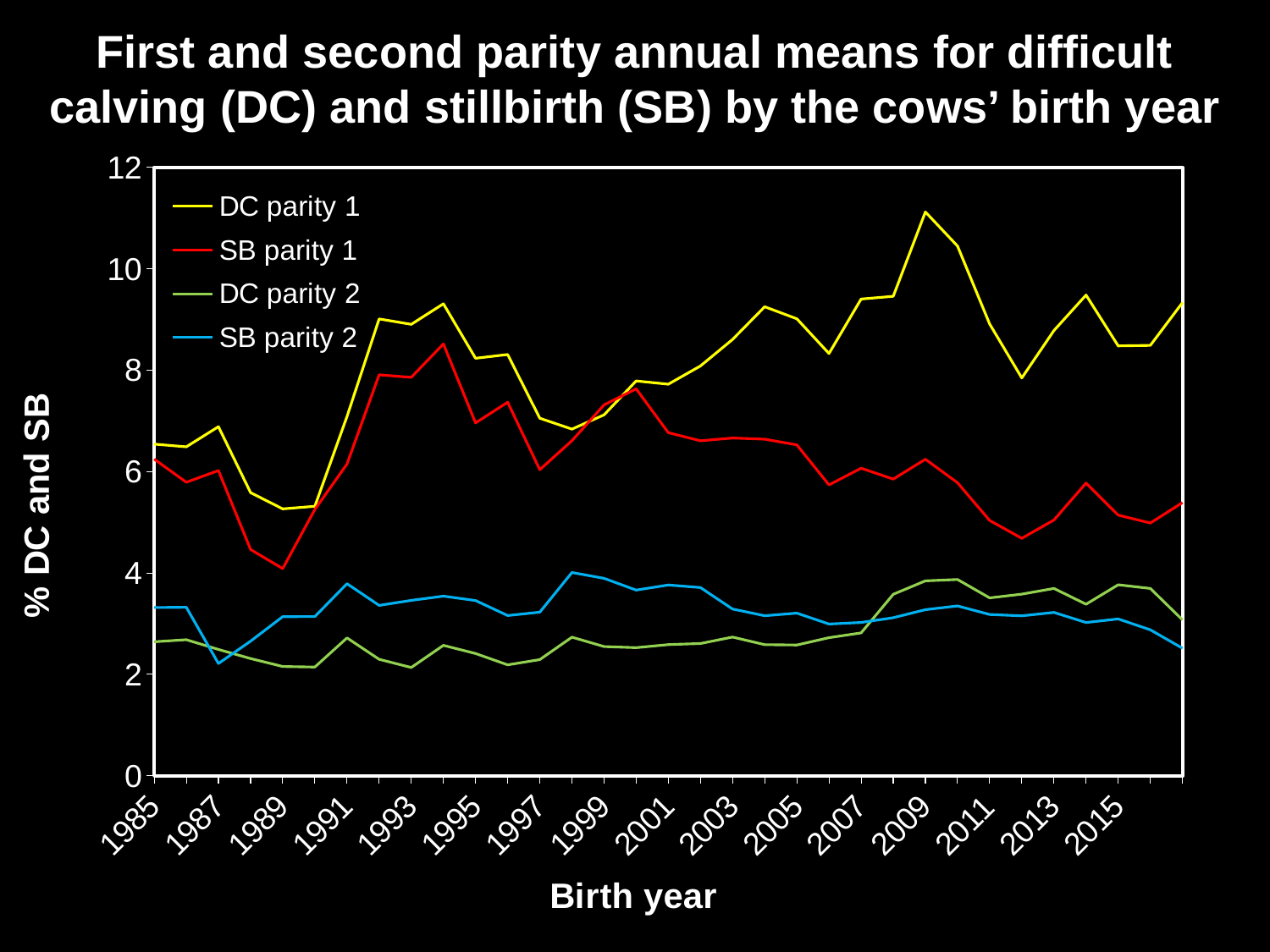
How many series does the legend list? 4 Is the value for DC parity 1 in 2009 greater or less than 10? greater Which series reaches the highest value on the chart? DC parity 1 Is the value for SB parity 2 in 1998 greater or less than 3? greater In which birth year does DC parity 1 reach its highest value? 2009 Is the value for SB parity 1 in 1990 greater or less than 6? less In 2009, which is larger: DC parity 1 or SB parity 1? DC parity 1 Does SB parity 1 generally rise or fall from 2001 to 2012? fall What kind of chart is shown on the slide? line chart In 1985, which is larger: DC parity 2 or SB parity 2? SB parity 2 What is the label on the vertical axis? % DC and SB